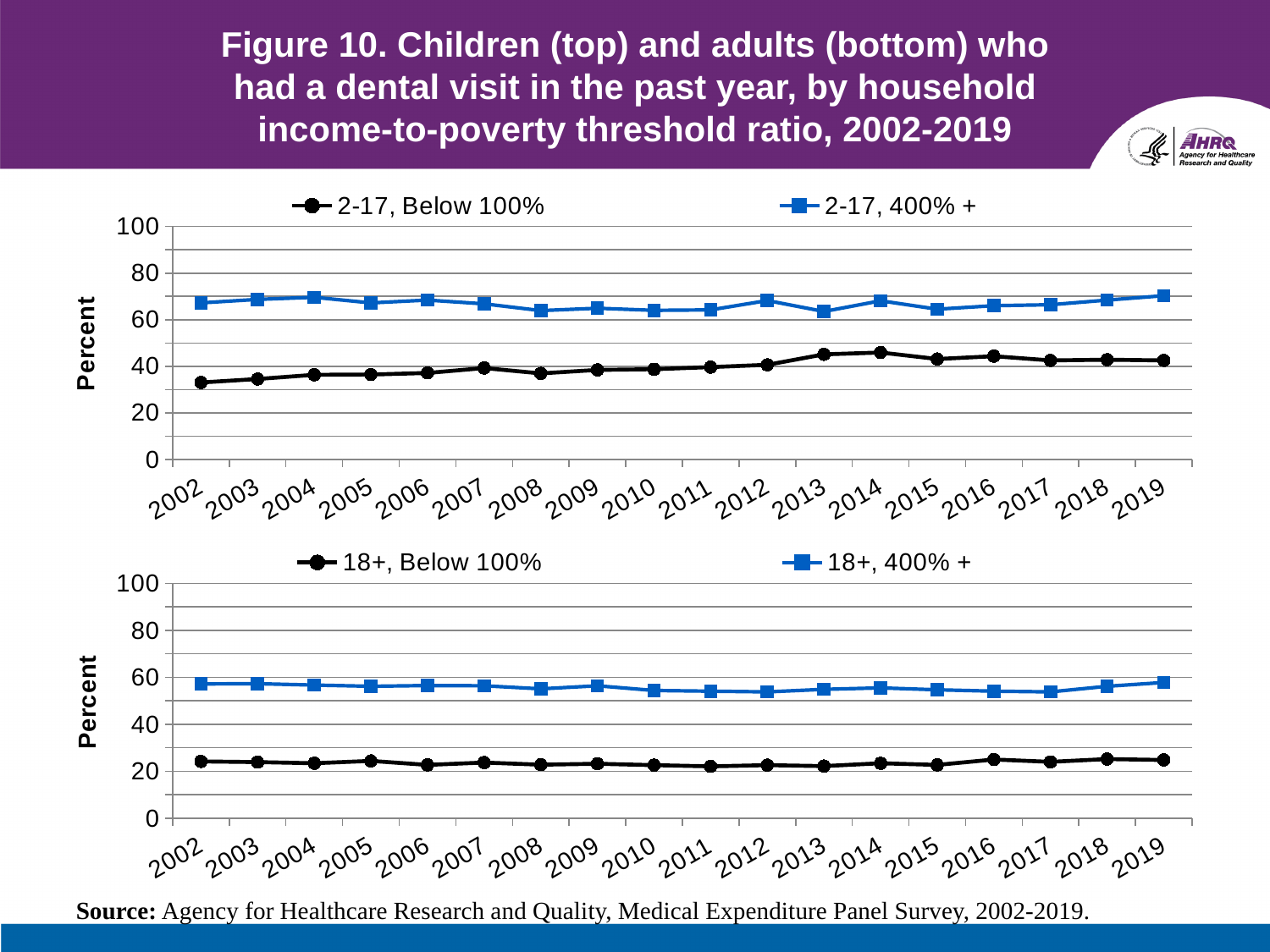
In the bottom chart, is the value for 18+, Below 100% in 2019 greater or less than 20? greater In the top chart, is the value for 2-17, 400% + in 2002 greater or less than 60? greater How many years are plotted along the x axis of the bottom chart? 18 In the bottom chart, is the value for 18+, 400% + in 2011 greater or less than 60? less In the bottom chart, which series has the lower value in 2010, 18+, Below 100% or 18+, 400% +? 18+, Below 100% What is the label on the y axis of the bottom chart? Percent How many series does the legend of the top chart list? 2 What colour is the line for the 18+, 400% + series in the bottom chart? blue In the top chart, does the 2-17, Below 100% series generally rise or fall from 2002 to 2019? rise In the top chart, which series has the higher value in 2019, 2-17, Below 100% or 2-17, 400% +? 2-17, 400% + What type of chart is the top chart on the slide? line chart